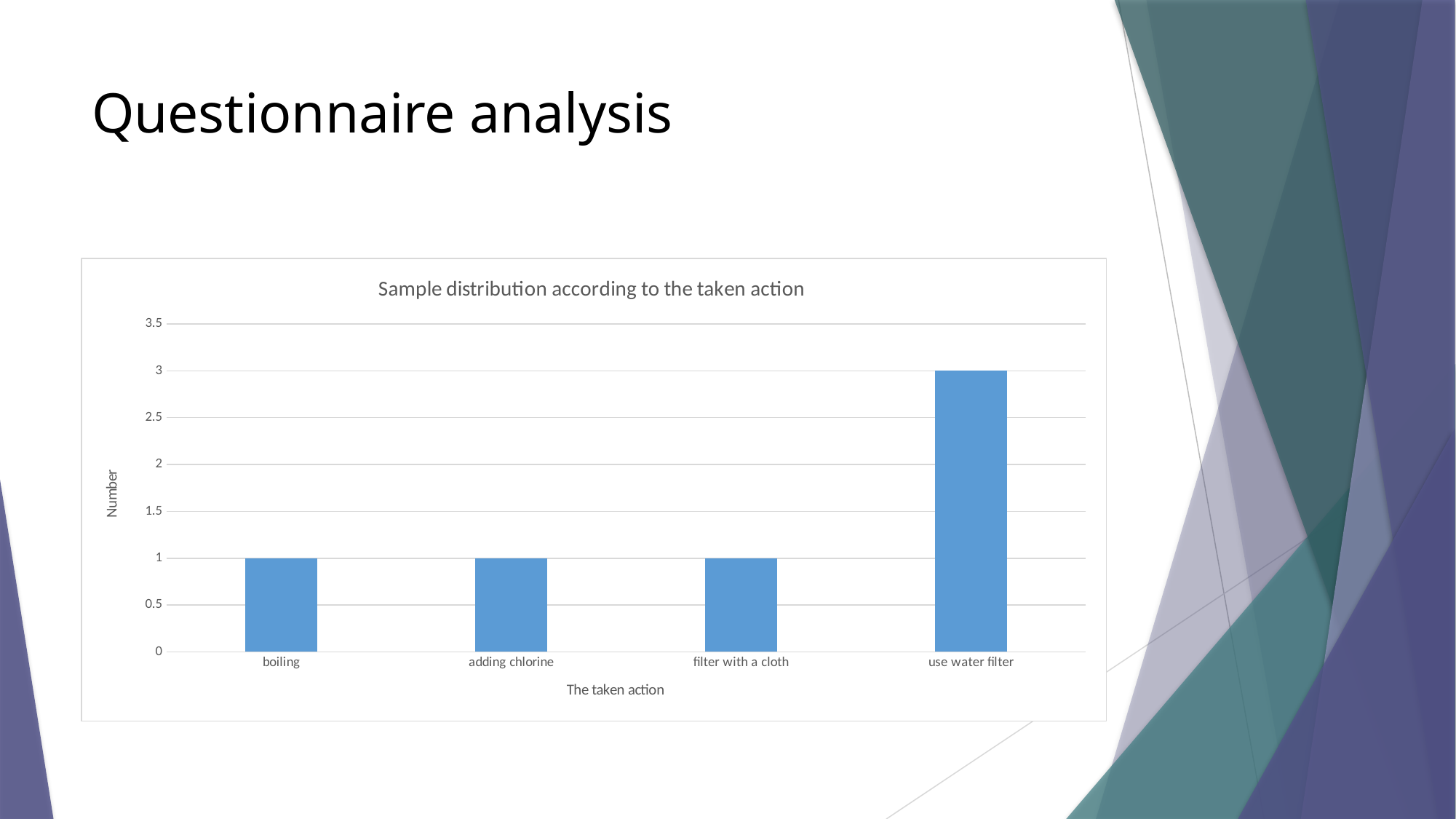
What is the value for filter with a cloth? 1 How many categories are shown on the x axis? 4 Which is larger, the value for use water filter or the value for filter with a cloth? use water filter Is the value for adding chlorine greater or less than 2? less Which action has the highest value? use water filter What is the title of the chart? Sample distribution according to the taken action What is the difference between the values for use water filter and boiling? 2 What kind of chart is shown on the slide? bar chart What is the value for adding chlorine? 1 Is the value for use water filter greater or less than 2? greater What is the value for use water filter? 3 What is the value for boiling? 1